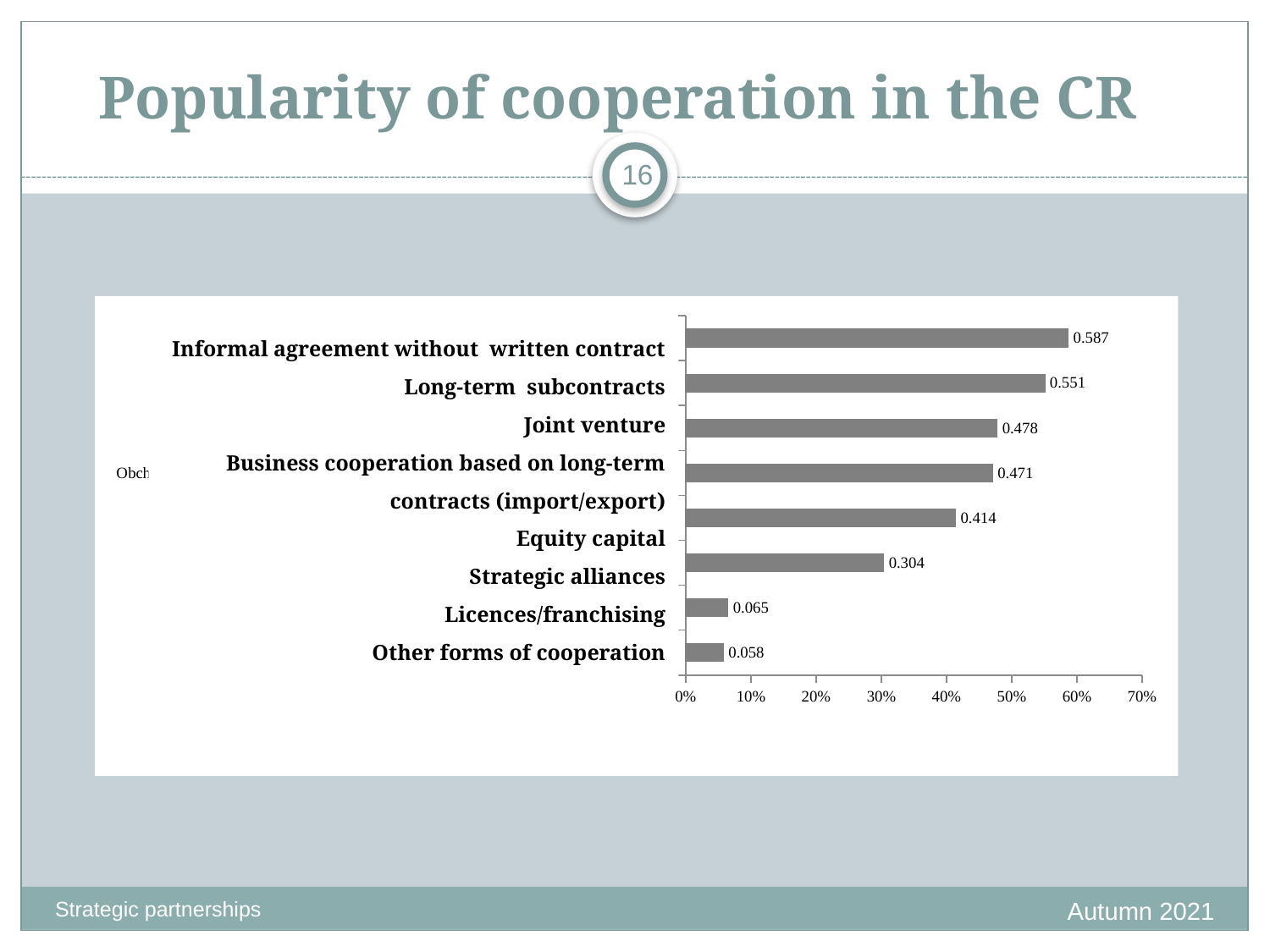
What is the value shown for Licences/franchising? 0.065 Which is larger, the value for Equity capital or the value for Strategic alliances? Equity capital What is the value shown for Strategic alliances? 0.304 Which category has the highest value? Informal agreement without written contract What is the difference between the values for Informal agreement without written contract and Long-term subcontracts? 0.036 What kind of chart is shown on the slide? bar chart How many categories (bars) does the chart show? 8 What is the value shown for Informal agreement without written contract? 0.587 Is the value for Joint venture greater or less than 40%? greater Which category has the lowest value? Other forms of cooperation What is the value shown for Long-term subcontracts? 0.551 What is the value shown for Joint venture? 0.478